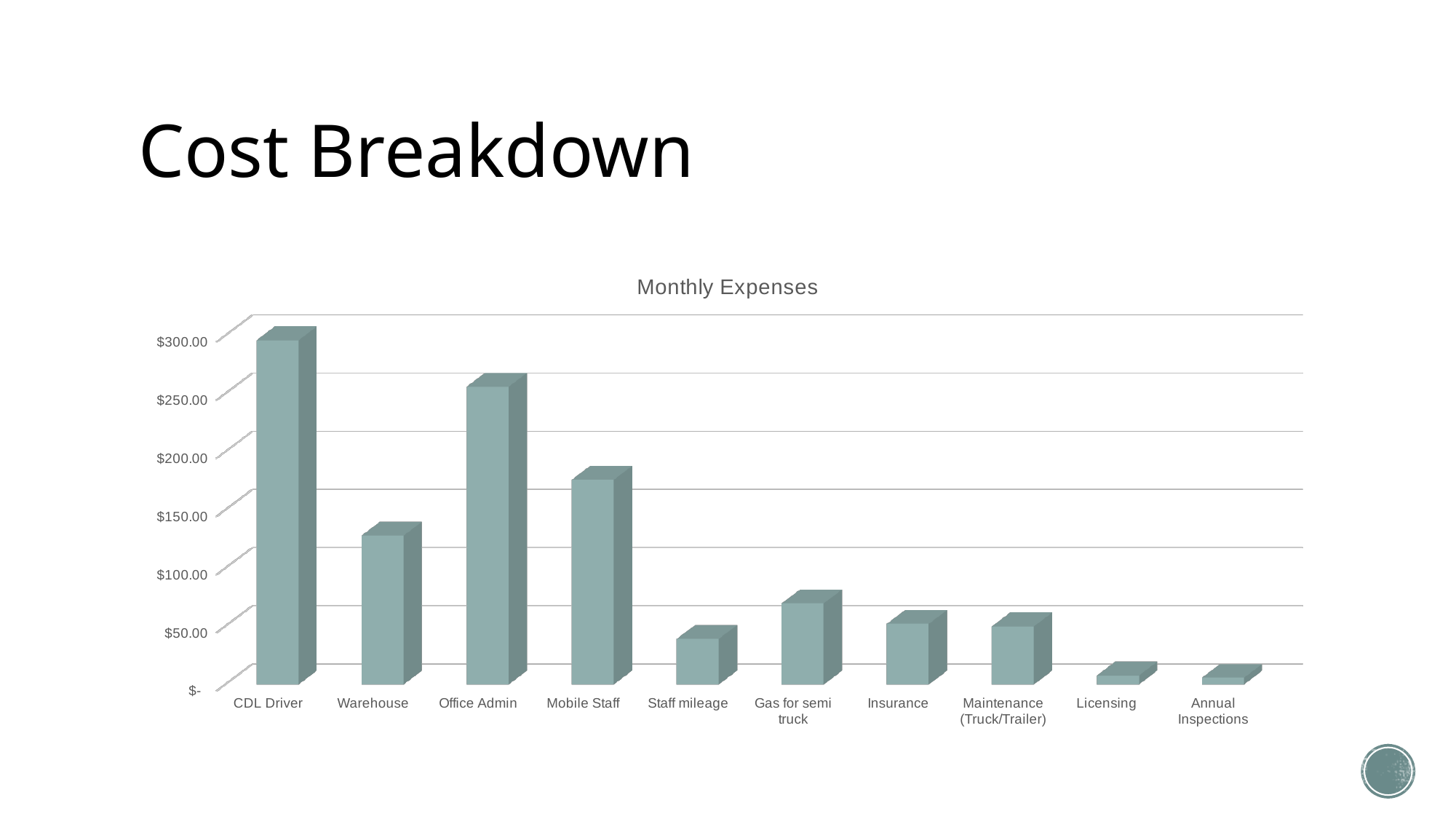
Is the value for CDL Driver greater or less than $250.00? greater What is the title of the chart? Monthly Expenses Is the value for Mobile Staff greater or less than $150.00? greater Which is larger, the value for Warehouse or the value for Gas for semi truck? Warehouse Is the value for Office Admin greater or less than $200.00? greater What kind of chart is shown on the slide? bar chart Which category has the highest monthly expense? CDL Driver Which is larger, the value for Office Admin or the value for Mobile Staff? Office Admin How many expense categories are shown on the x axis? 10